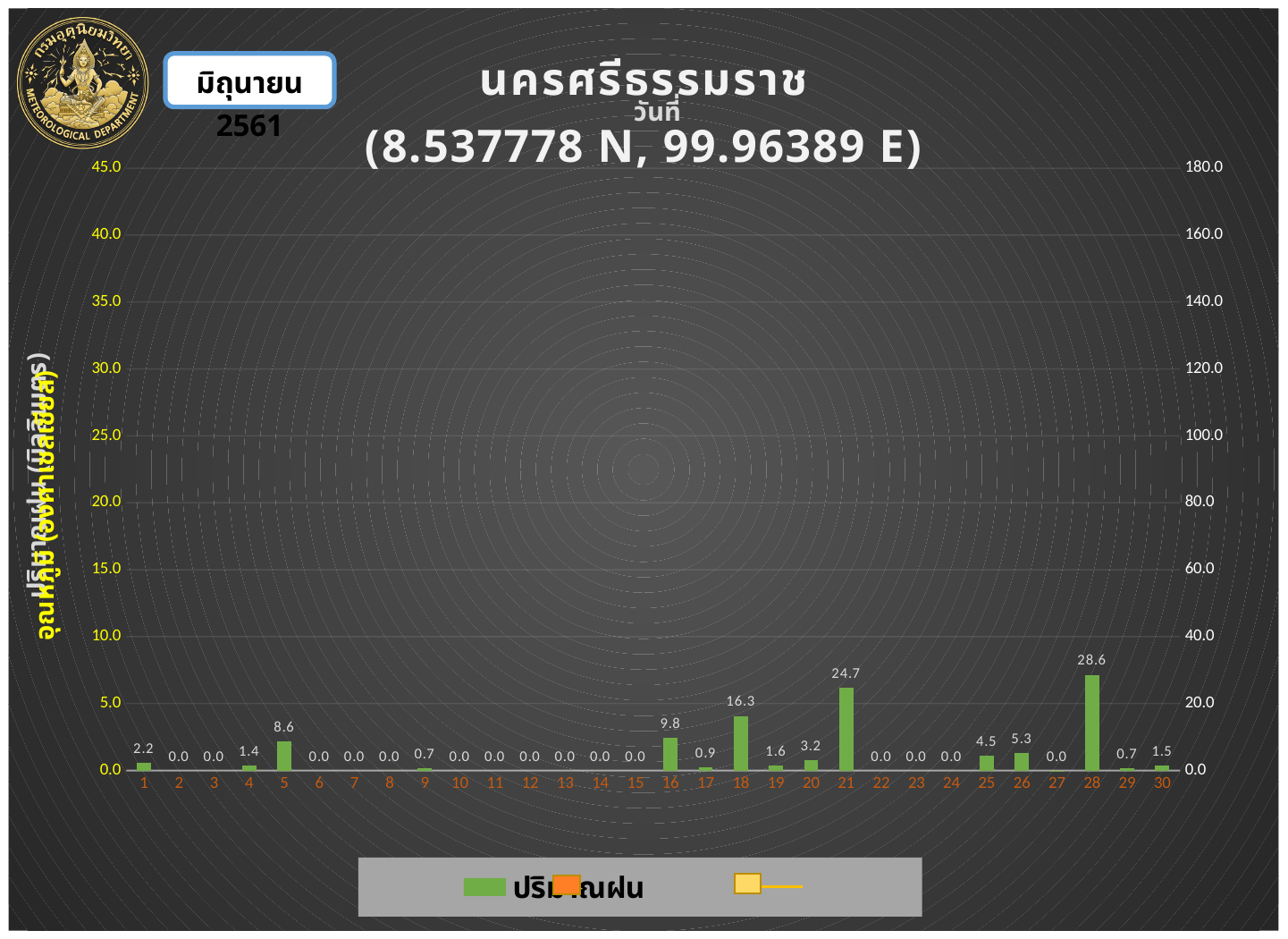
What is the rainfall value shown for day 21? 24.7 What is the rainfall value shown for day 20? 3.2 What is the rainfall value shown for day 18? 16.3 Which has the larger rainfall value, day 16 or day 18? day 18 What are the coordinates shown in the chart title? 8.537778 N, 99.96389 E What is the difference between the rainfall values for day 28 and day 21? 3.9 What kind of chart is shown on the slide? bar chart What is the rainfall value shown for day 5? 8.6 How many days are shown on the x axis? 30 Which day has the highest rainfall bar? 28 What is the difference between the rainfall values for day 26 and day 25? 0.8 What is the rainfall value shown for day 28? 28.6